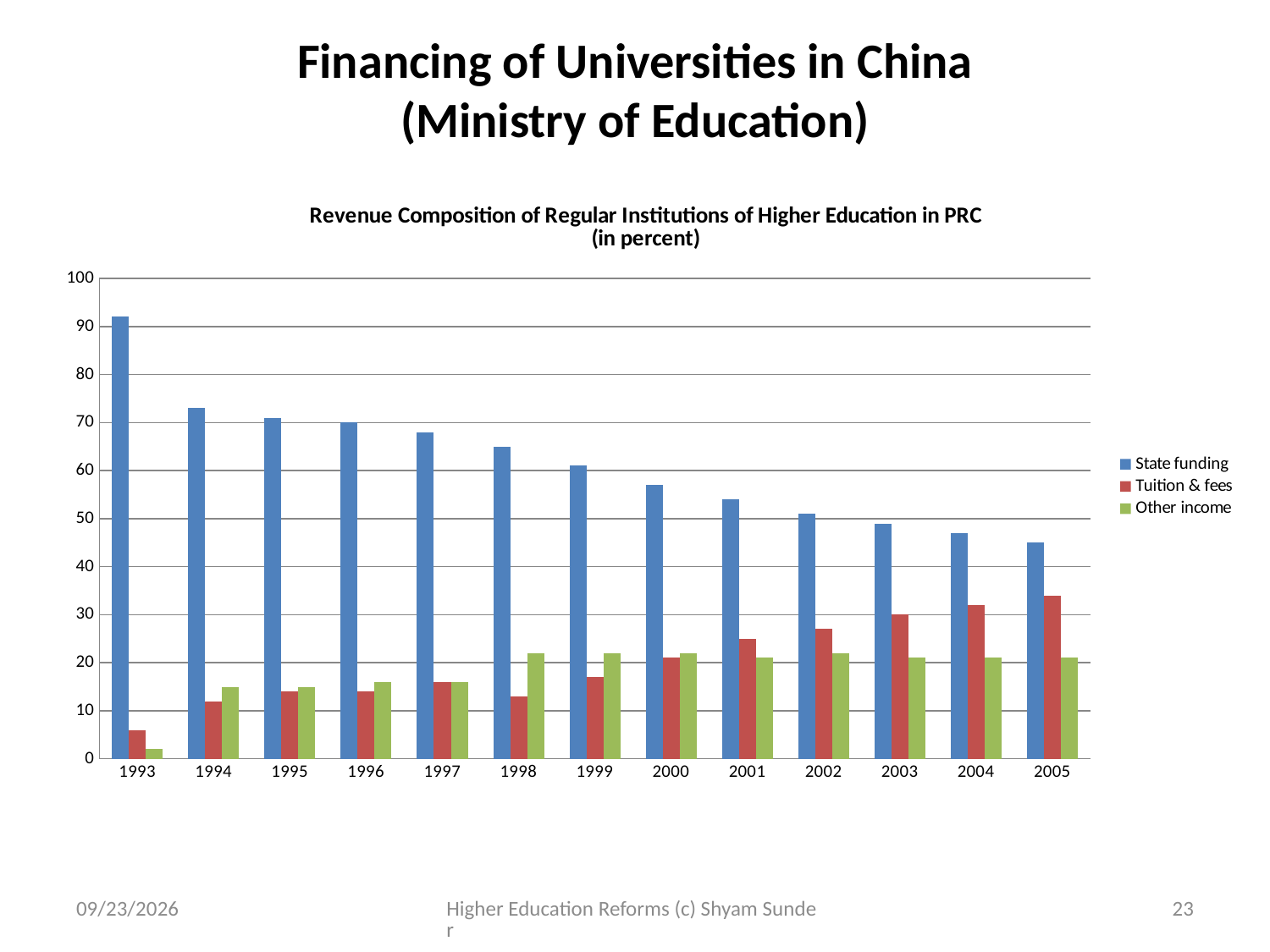
What kind of chart is shown on the slide? Bar chart How many series does the legend list? 3 In which year is Other income lowest? 1993 Is the value for Tuition & fees in 2005 greater or less than 30? greater Is the value for State funding in 2005 greater or less than 50? less How many years are shown on the x axis? 13 Is the value for State funding in 1993 greater or less than 90? greater In 1998, which is larger: Tuition & fees or Other income? Other income In which year is Tuition & fees highest? 2005 In which year is State funding lowest? 2005 Does State funding rise or fall from 1993 to 2005? Fall In which year is State funding highest? 1993